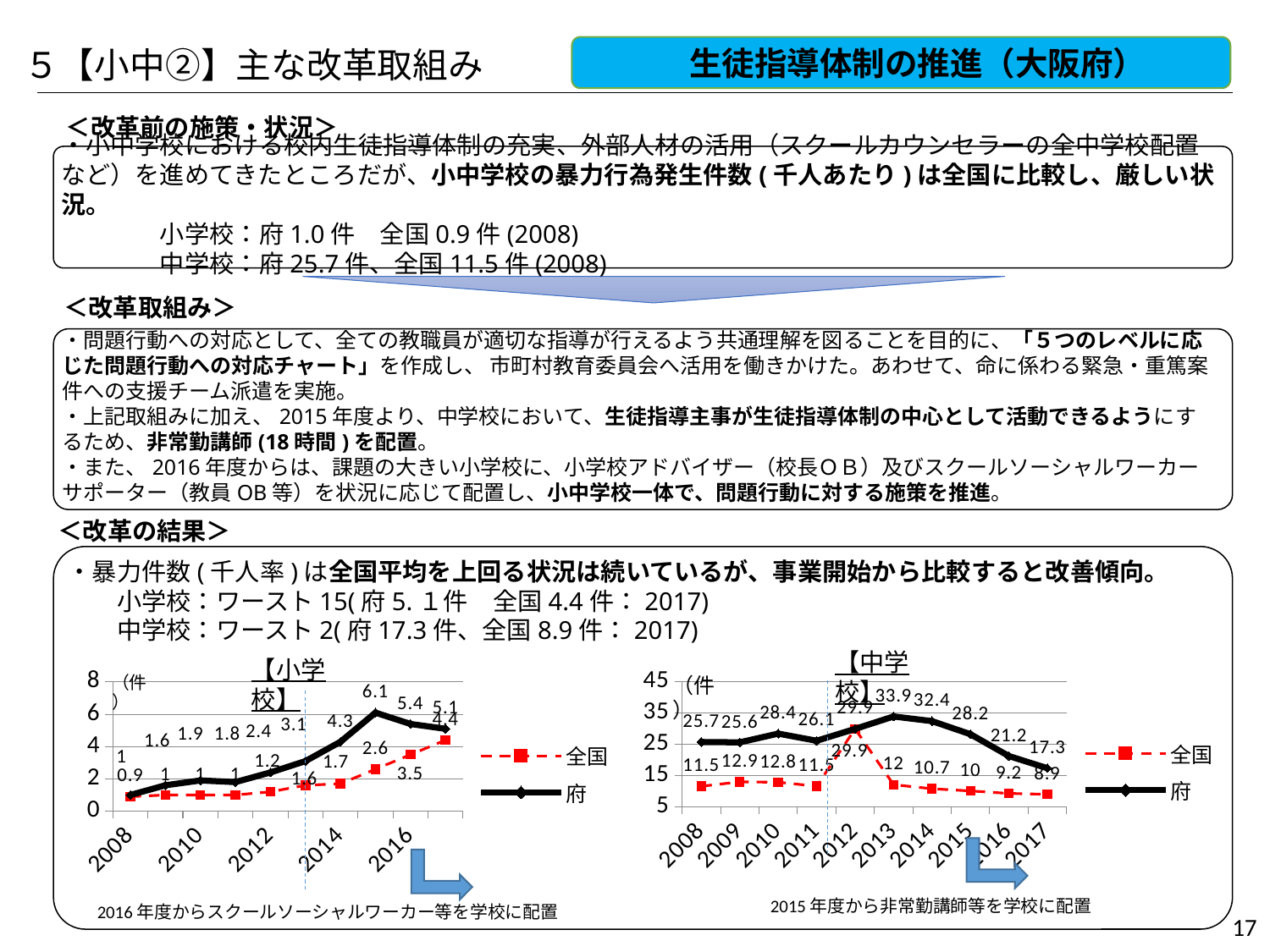
In the 【中学校】 chart, does the 府 series rise or fall from 2013 to 2017? fall In the 【小学校】 chart, what is the difference between 府 and 全国 in 2016? 1.9 In the 【小学校】 chart, what is the value for 府 in 2008? 1 In the 【中学校】 chart, what is the value for 府 in 2017? 17.3 In the 【小学校】 chart, what is the value for 全国 in 2016? 3.5 In the 【中学校】 chart, which series is larger in 2010, 府 or 全国? 府 How many series does the legend of the 【中学校】 chart list? 2 In the 【中学校】 chart, in which year does the 府 series reach its highest value? 2013 In the 【中学校】 chart, what is the difference between 府 and 全国 in 2017? 8.4 What type of chart is the 【小学校】 chart on the left? line chart In the 【小学校】 chart, what is the highest value reached by the 府 series? 6.1 In the 【中学校】 chart, what is the value for 全国 in 2008? 11.5